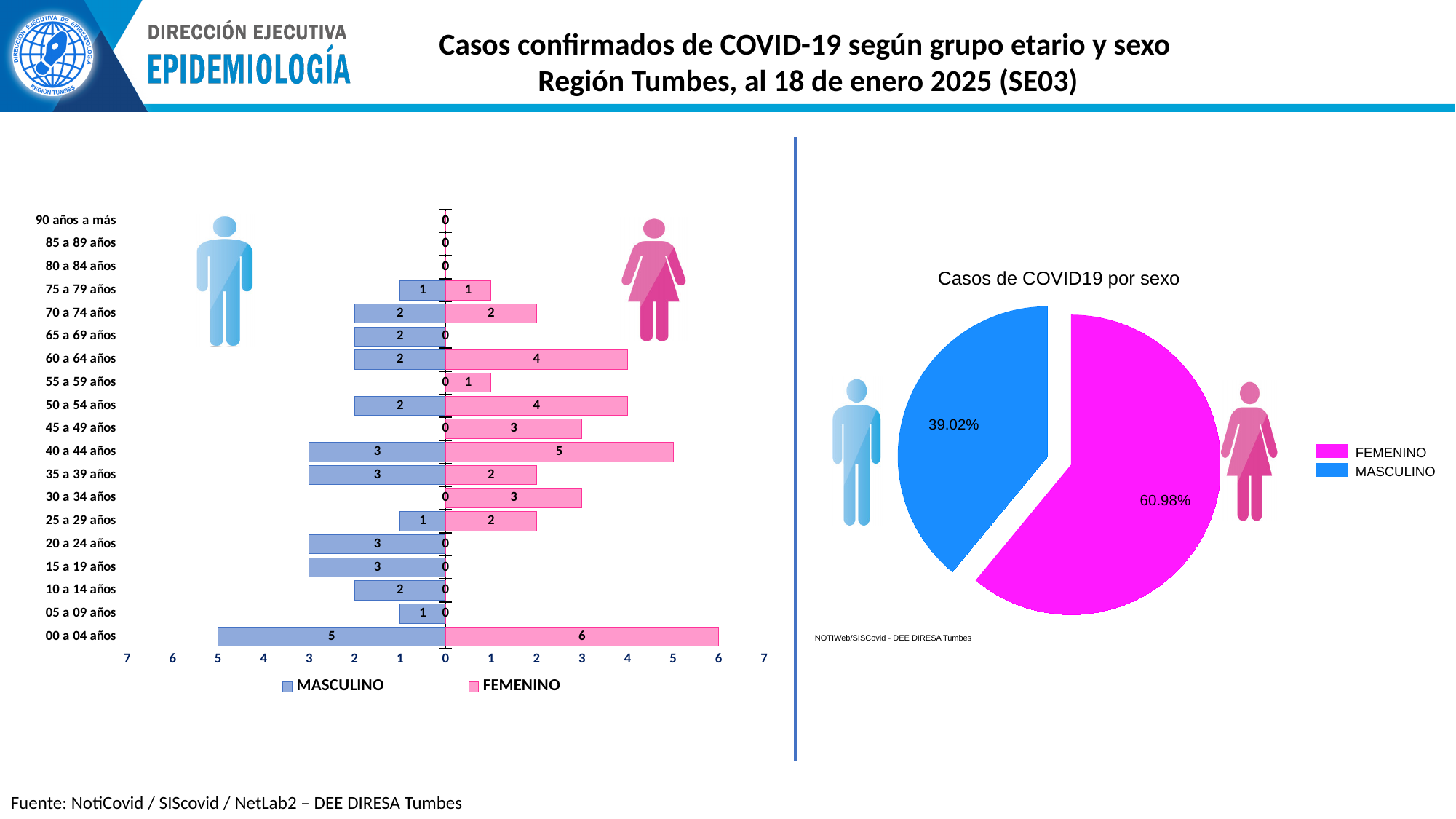
In the pie chart 'Casos de COVID19 por sexo', what share of cases is MASCULINO? 39.02% In the left bar chart, which is larger in the 35 a 39 años group, MASCULINO or FEMENINO? MASCULINO In the left bar chart, how many FEMENINO cases are in the 40 a 44 años group? 5 In the left bar chart, how many series does the legend list? 2 What type of chart is shown on the right side of the slide? Pie chart In the left bar chart, which age group has the highest number of MASCULINO cases? 00 a 04 años In the pie chart 'Casos de COVID19 por sexo', what share of cases is FEMENINO? 60.98% In the left bar chart, how many MASCULINO cases are in the 00 a 04 años group? 5 In the left bar chart, which age group has the highest number of FEMENINO cases? 00 a 04 años In the left bar chart, what is the difference between FEMENINO and MASCULINO cases in the 50 a 54 años group? 2 In the left bar chart, how many FEMENINO cases are in the 60 a 64 años group? 4 In the left bar chart, how many age groups are shown on the vertical axis? 19